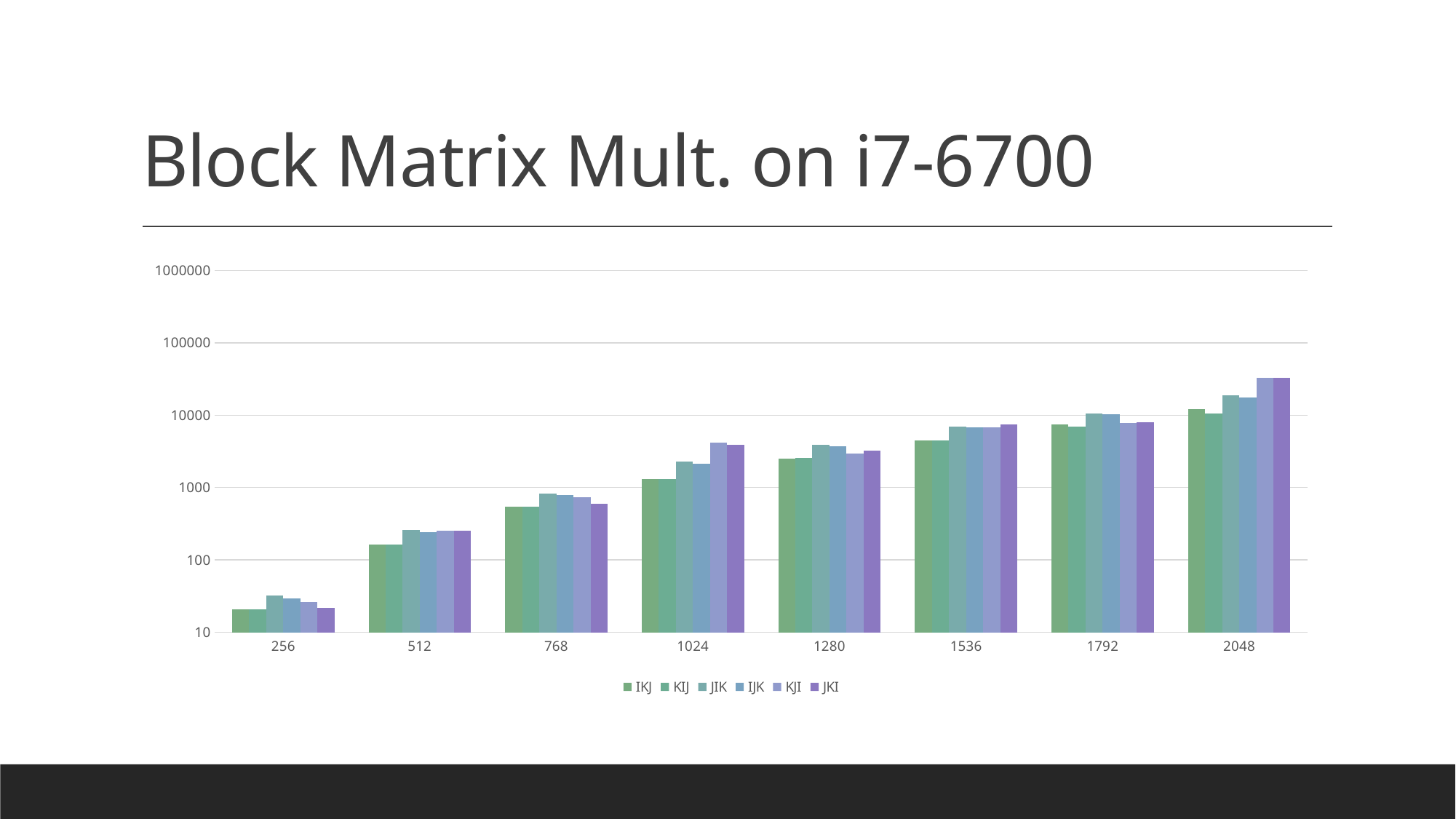
Is the value for JKI at 1536 greater or less than 10000? less What kind of chart is shown on the slide? bar chart How many matrix-size categories are shown on the x axis? 8 How many series does the legend list? 6 What is the title of the slide? Block Matrix Mult. on i7-6700 At 2048, which is larger, the value for KJI or the value for IKJ? KJI Is the value for IKJ at 1024 greater or less than 1000? greater Is the value for KJI at 2048 greater or less than 10000? greater Do the values for IKJ rise or fall as the matrix size increases along the x axis? rise What is the highest value labelled on the y axis? 1000000